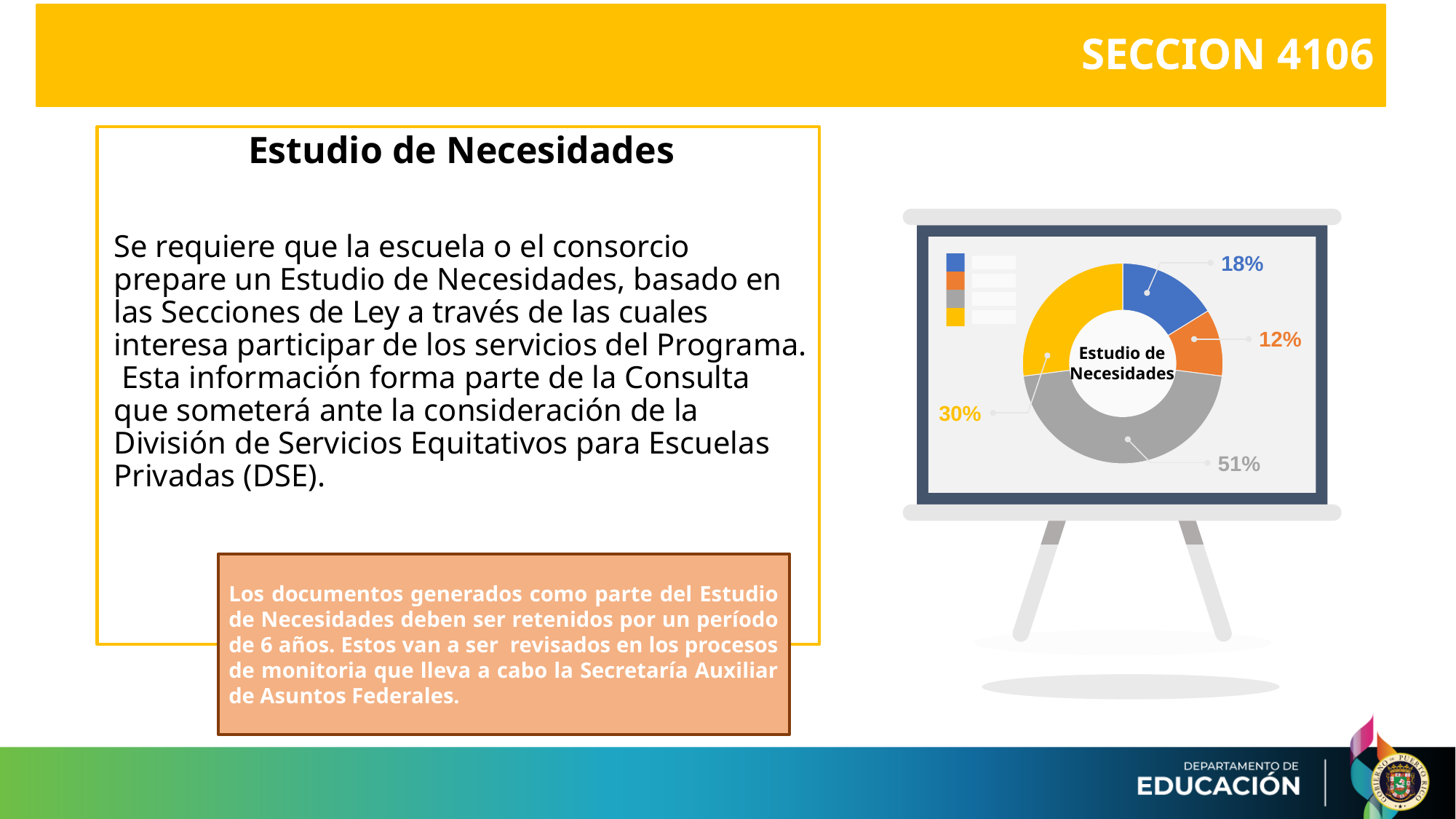
Which is larger in the donut chart, the blue slice or the yellow slice? The yellow slice (30%) How many entries does the legend of the donut chart show? 4 Which colour slice of the donut chart has the smallest value? Orange (12%) What kind of chart is shown on the slide? Donut (pie) chart What value is shown for the orange slice of the donut chart? 12% What is the difference between the gray slice and the yellow slice in the donut chart? 21 percentage points Which colour slice of the donut chart has the largest value? Gray (51%) What value is shown for the gray slice of the donut chart? 51% What value is shown for the yellow slice of the donut chart? 30% How many slices does the donut chart have? 4 What value is shown for the blue slice of the donut chart? 18% What text appears in the centre of the donut chart? Estudio de Necesidades